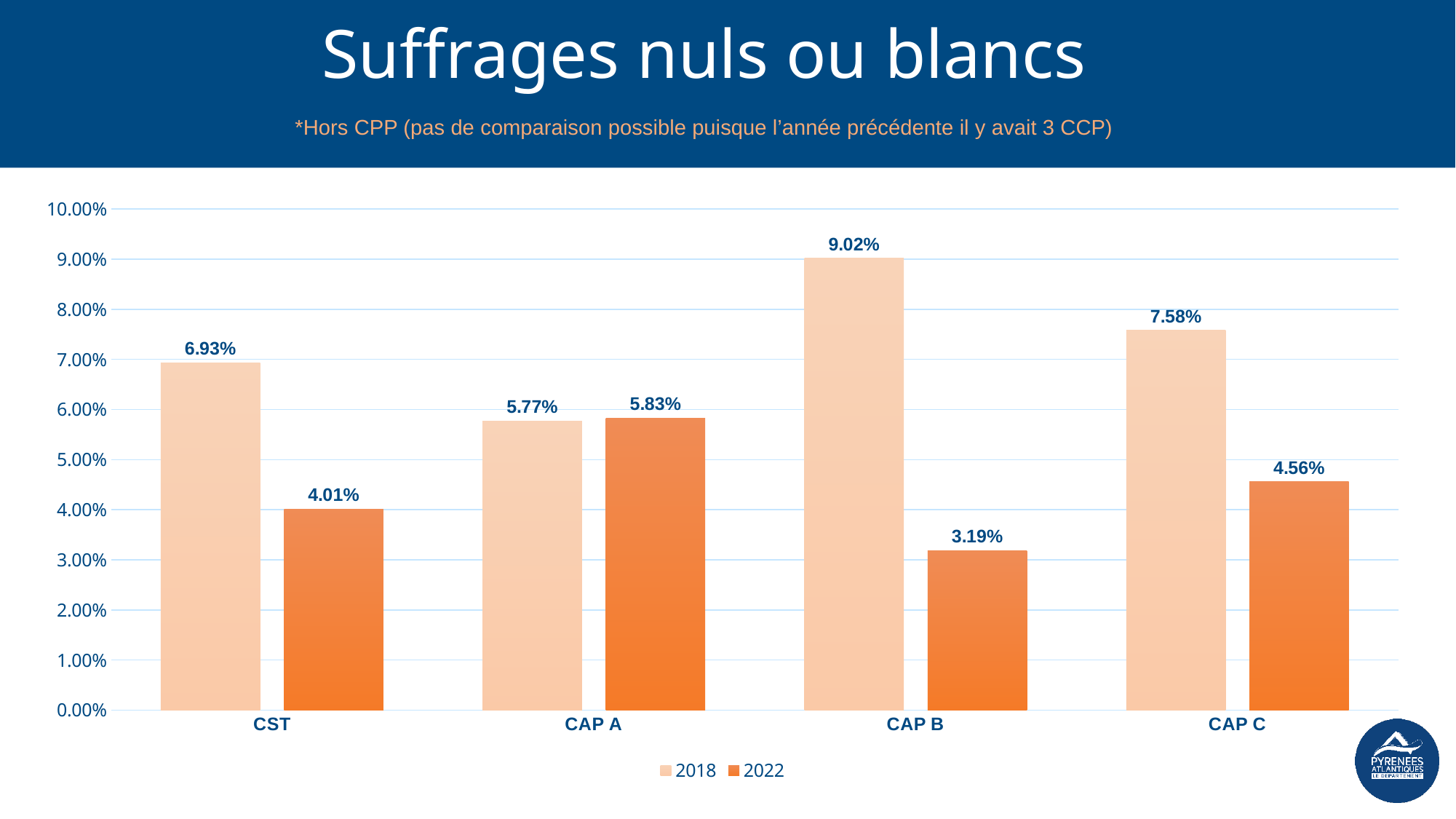
What is the title of the slide? Suffrages nuls ou blancs Which category has the lowest 2022 value? CAP B What is the 2018 value for CAP B? 9.02% How many categories are shown on the x axis? 4 What is the difference between the 2018 and 2022 values for CAP B? 5.83% Which category has the highest 2018 value? CAP B What is the 2022 value for CAP C? 4.56% Which is larger for CAP A, the 2018 value or the 2022 value? 2022 What kind of chart is shown on the slide? Bar chart How many series does the legend list? 2 What is the difference between the 2018 and 2022 values for CST? 2.92% What is the 2022 value for CST? 4.01%